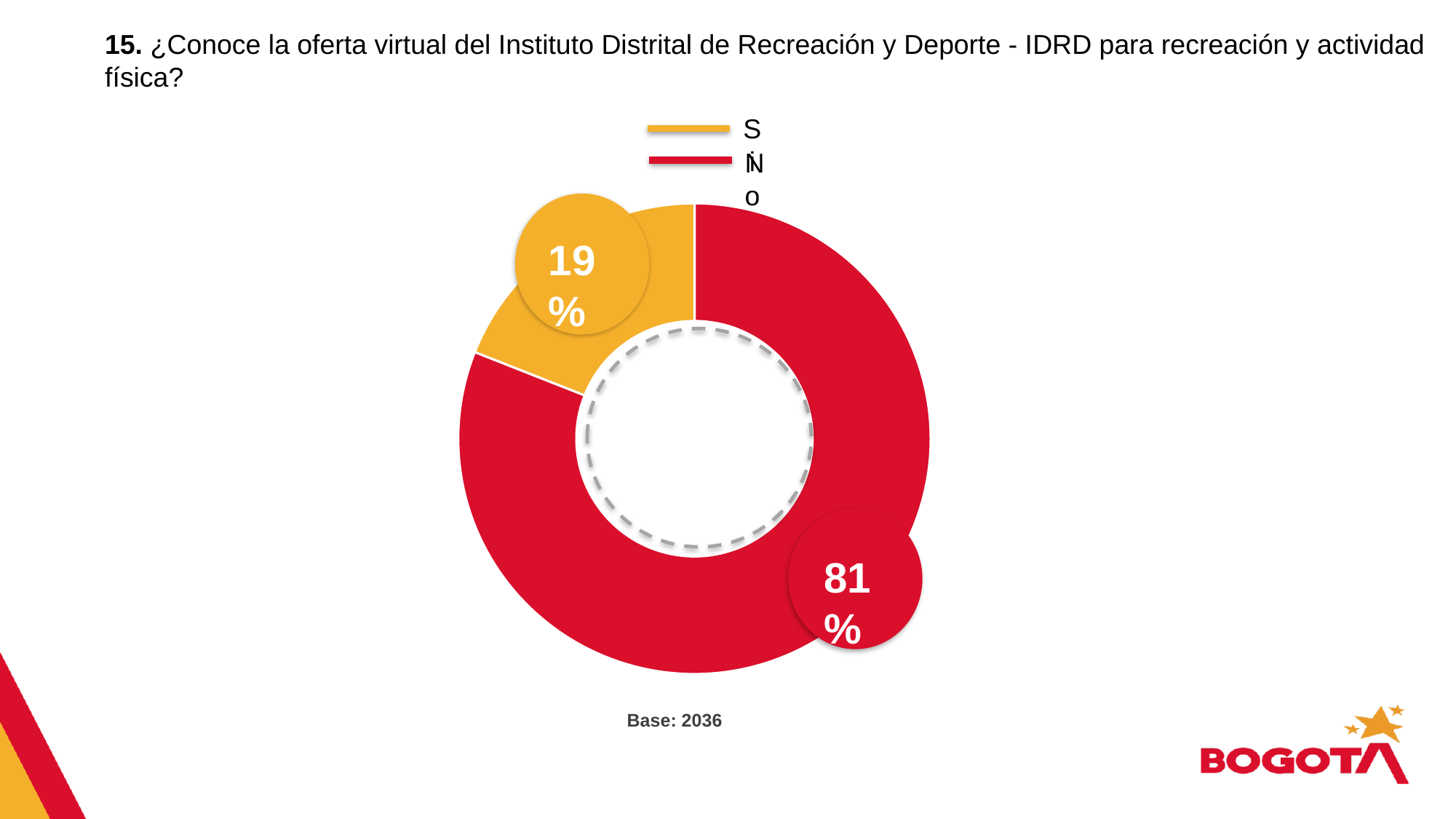
What kind of chart is shown on the slide? Pie chart (donut) How many entries does the legend list? 2 What percentage of respondents answered "Sí"? 19% How many categories are shown in the chart? 2 Which response has the smallest share of the chart? Sí What is the difference in percentage points between the "No" and "Sí" responses? 62 Which response has the largest share of the chart? No Which is larger, the share for "Sí" or the share for "No"? No What share of the pie does the "Sí" slice represent? 19% What percentage of respondents answered "No"? 81% What is the base (number of respondents) shown below the chart? 2036 What colour is used for the "No" slice? Red